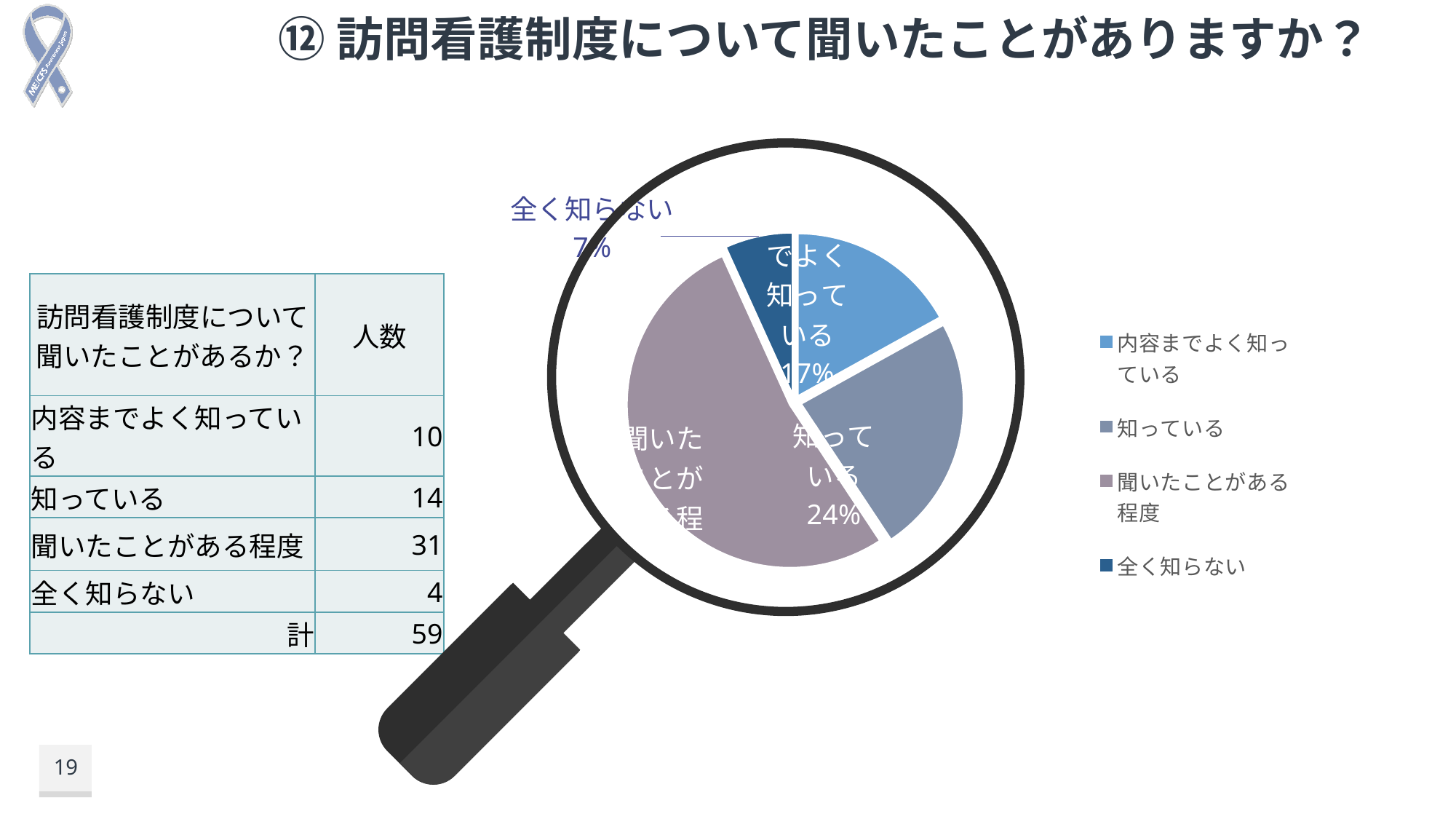
What percentage does the pie chart show for 知っている? 24% What percentage does the pie chart show for 内容までよく知っている? 17% Which category has the largest slice in the pie chart? 聞いたことがある程度 What is the difference in percentage points between the 知っている slice and the 全く知らない slice? 17 How many slices does the pie chart have? 4 Which legend entry is shown in the darkest blue colour? 全く知らない How many entries does the legend of the pie chart list? 4 Which category has the smallest slice in the pie chart? 全く知らない Which slice is larger in the pie chart, 知っている or 内容までよく知っている? 知っている What percentage does the pie chart show for 全く知らない? 7% Which legend entry appears first in the pie chart's legend? 内容までよく知っている What kind of chart is shown on the slide? pie chart